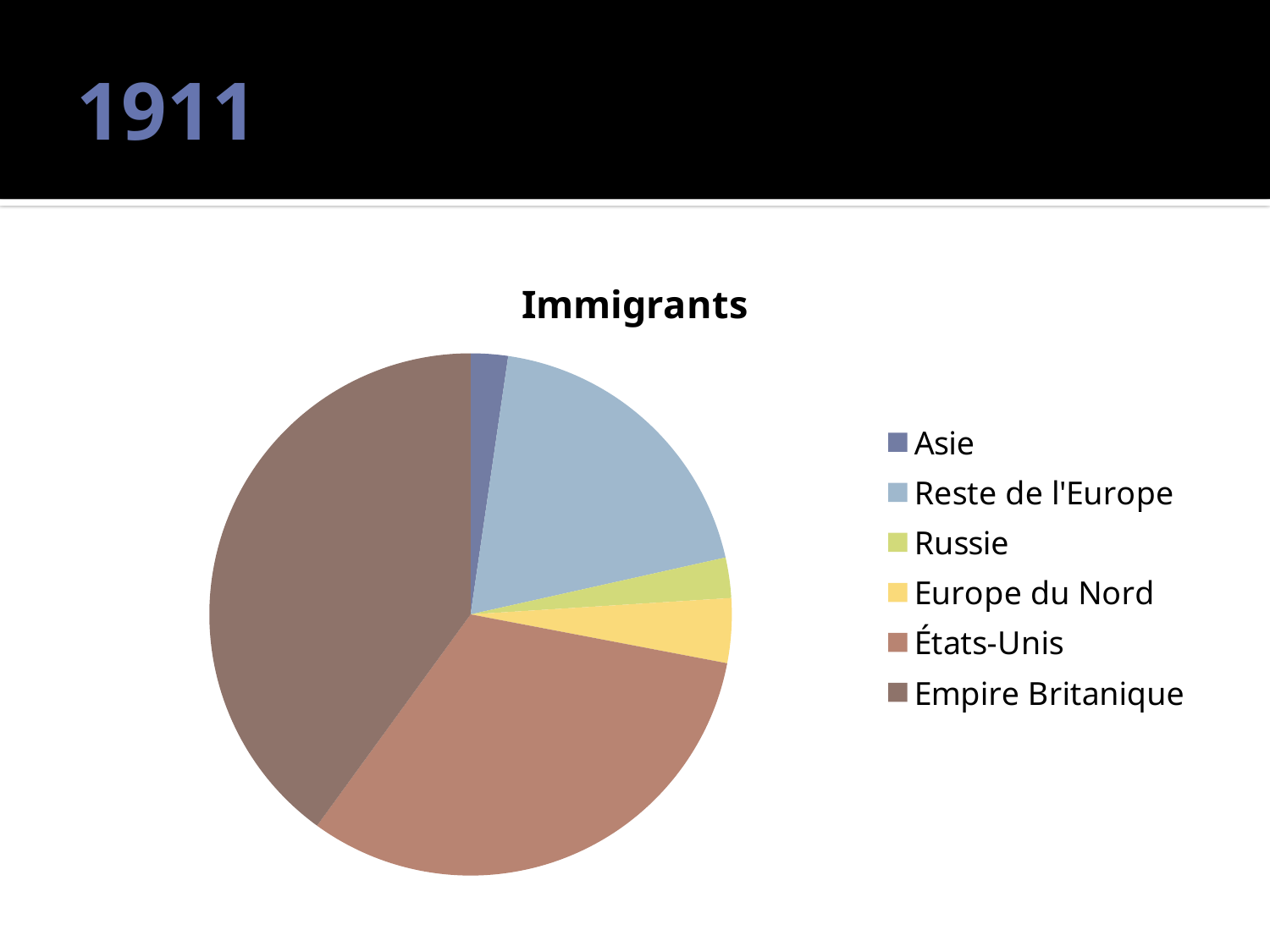
What kind of chart is shown on the slide? Pie chart What is the title of the chart? Immigrants Which slice is larger, États-Unis or Reste de l'Europe? États-Unis Which slice is larger, Empire Britanique or États-Unis? Empire Britanique What colour is the Empire Britanique slice? Brown Which legend entry is listed first? Asie Which category is the second largest slice of the pie? États-Unis Which slice is larger, Reste de l'Europe or Russie? Reste de l'Europe How many categories does the pie chart show? 6 Which category has the largest slice of the pie? Empire Britanique